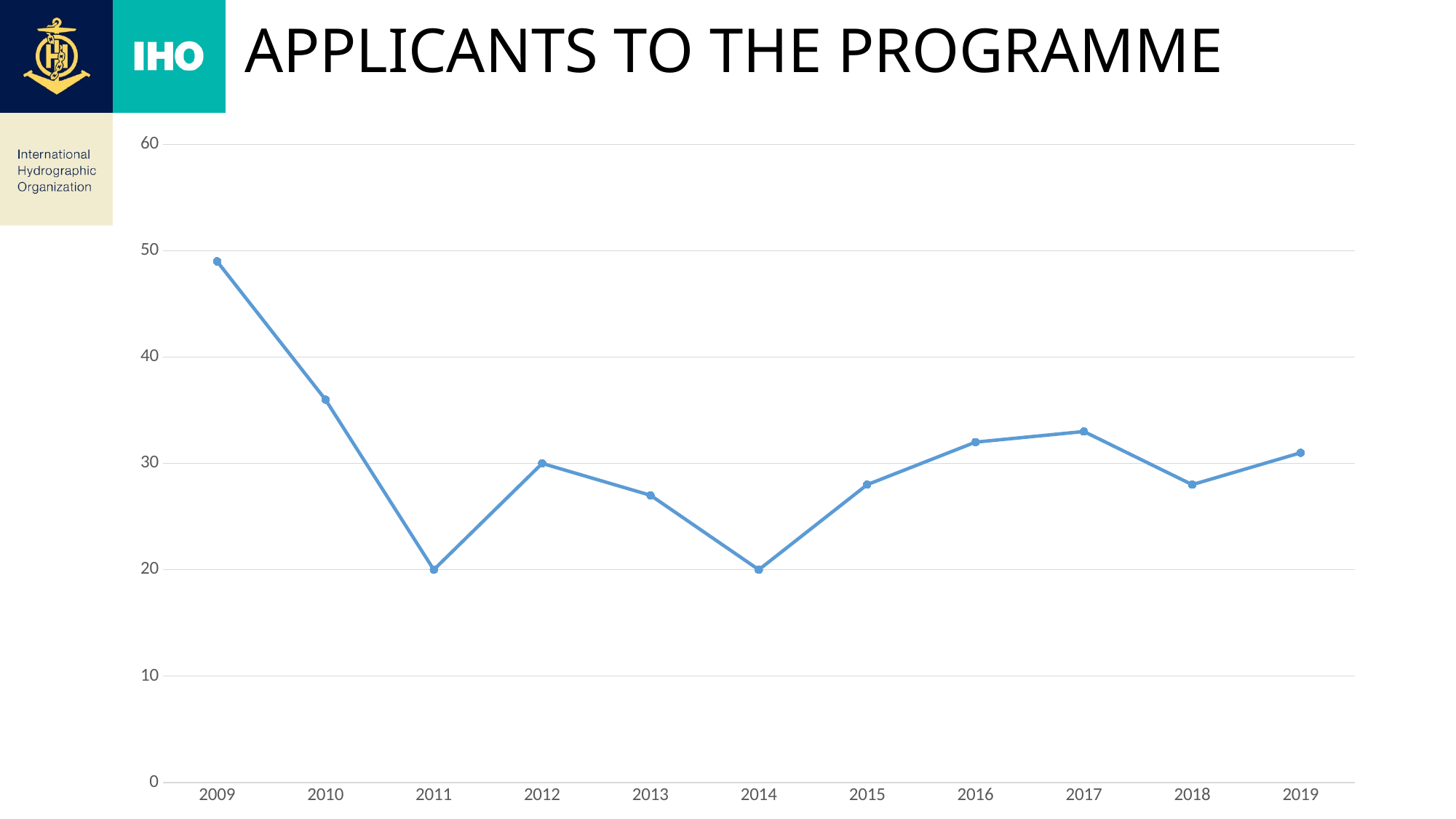
Is the value for 2010 greater or less than 40? less Which year has the larger value, 2016 or 2018? 2016 Is the value for 2013 greater or less than 30? less What is the value for 2014? 20 Do the values rise or fall from 2009 to 2011? fall What is the value for 2011? 20 Is the value for 2009 greater or less than 40? greater What kind of chart is shown on the slide? line chart Which year has the highest number of applicants? 2009 What is the title of the chart? APPLICANTS TO THE PROGRAMME How many years are plotted on the x axis? 11 What is the value for 2012? 30